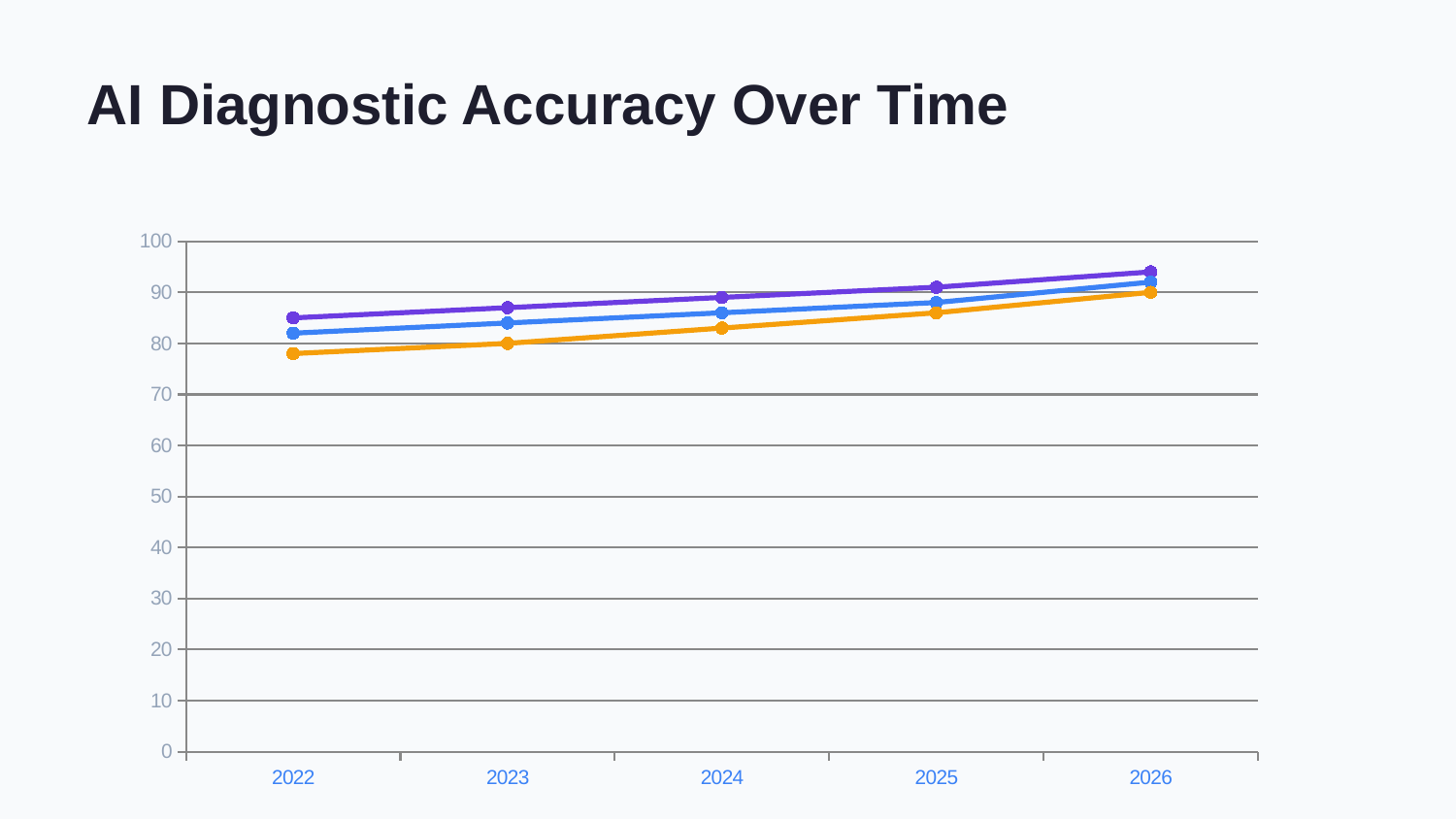
Is the value of the purple line in 2026 greater or less than 90? greater Which line has the lowest value in 2022? the orange line Is the value of the blue line in 2024 greater or less than 90? less In 2022, is the value of the purple line or the orange line larger? the purple line Is the value of the orange line in 2022 greater or less than 80? less What kind of chart is shown on the slide? line chart How many lines are plotted on the chart? 3 Which line has the highest value in 2022? the purple line Do the values of the purple line rise or fall from 2022 to 2026? rise What is the title of the chart? AI Diagnostic Accuracy Over Time Do the values of the orange line rise or fall from 2022 to 2026? rise How many years are shown along the x axis? 5